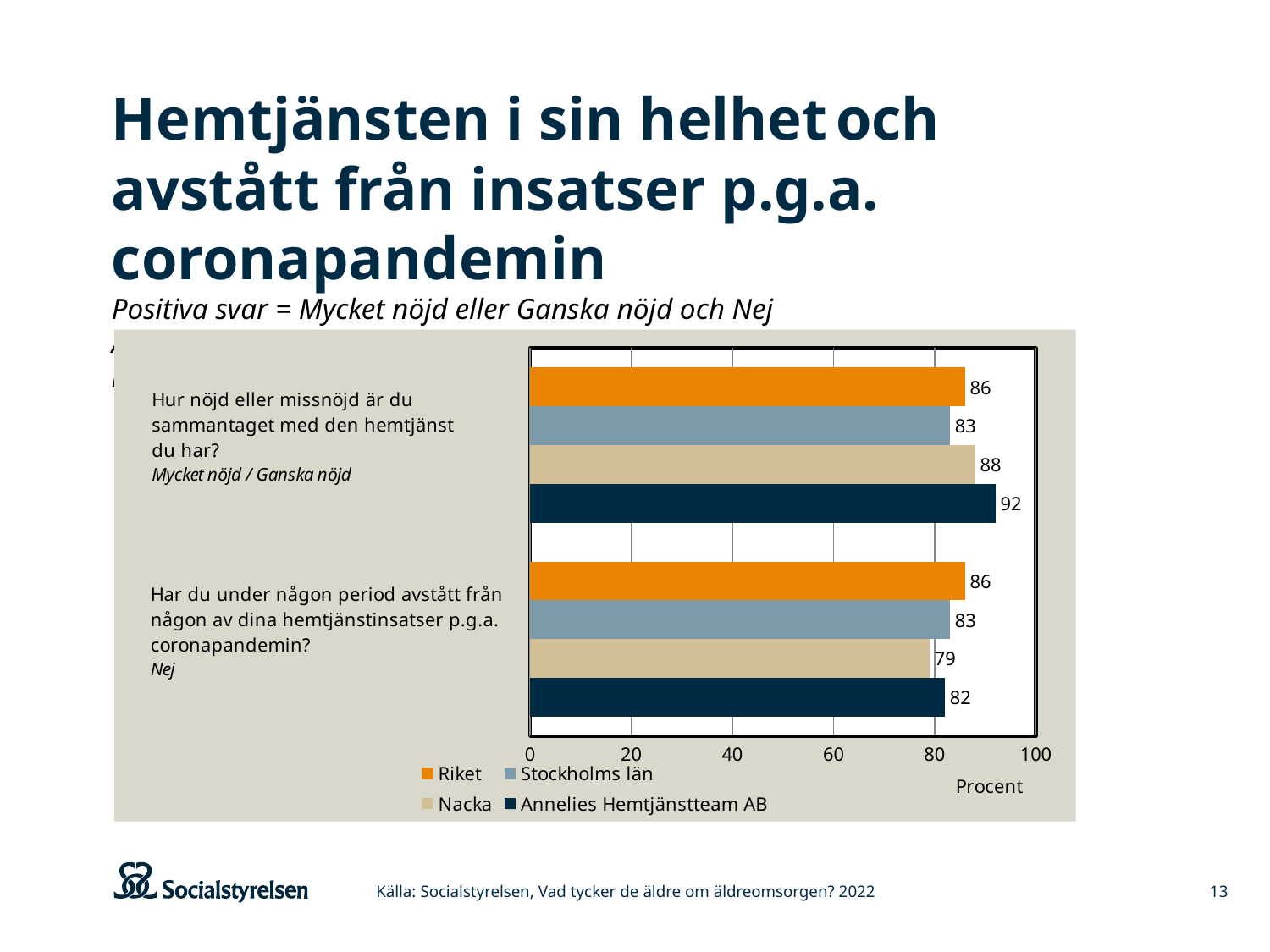
Which series has the lowest value for the question "Har du under någon period avstått från någon av dina hemtjänstinsatser p.g.a. coronapandemin?" Nacka What value does Annelies Hemtjänstteam AB have for the question "Hur nöjd eller missnöjd är du sammantaget med den hemtjänst du har?" 92 What value does Stockholms län have for the question "Har du under någon period avstått från någon av dina hemtjänstinsatser p.g.a. coronapandemin?" 83 What is the difference between the Annelies Hemtjänstteam AB value and the Riket value for the question "Hur nöjd eller missnöjd är du sammantaget med den hemtjänst du har?" 6 What value does Riket have for the question "Hur nöjd eller missnöjd är du sammantaget med den hemtjänst du har?" 86 How many series does the legend list? 4 What value does Nacka have for the question "Har du under någon period avstått från någon av dina hemtjänstinsatser p.g.a. coronapandemin?" 79 For the question "Har du under någon period avstått från någon av dina hemtjänstinsatser p.g.a. coronapandemin?", which is larger: the Riket value or the Annelies Hemtjänstteam AB value? Riket What is the label on the horizontal axis of the chart? Procent Which series has the highest value for the question "Hur nöjd eller missnöjd är du sammantaget med den hemtjänst du har?" Annelies Hemtjänstteam AB What kind of chart is shown on the slide? Bar chart How many question categories are shown on the chart? 2